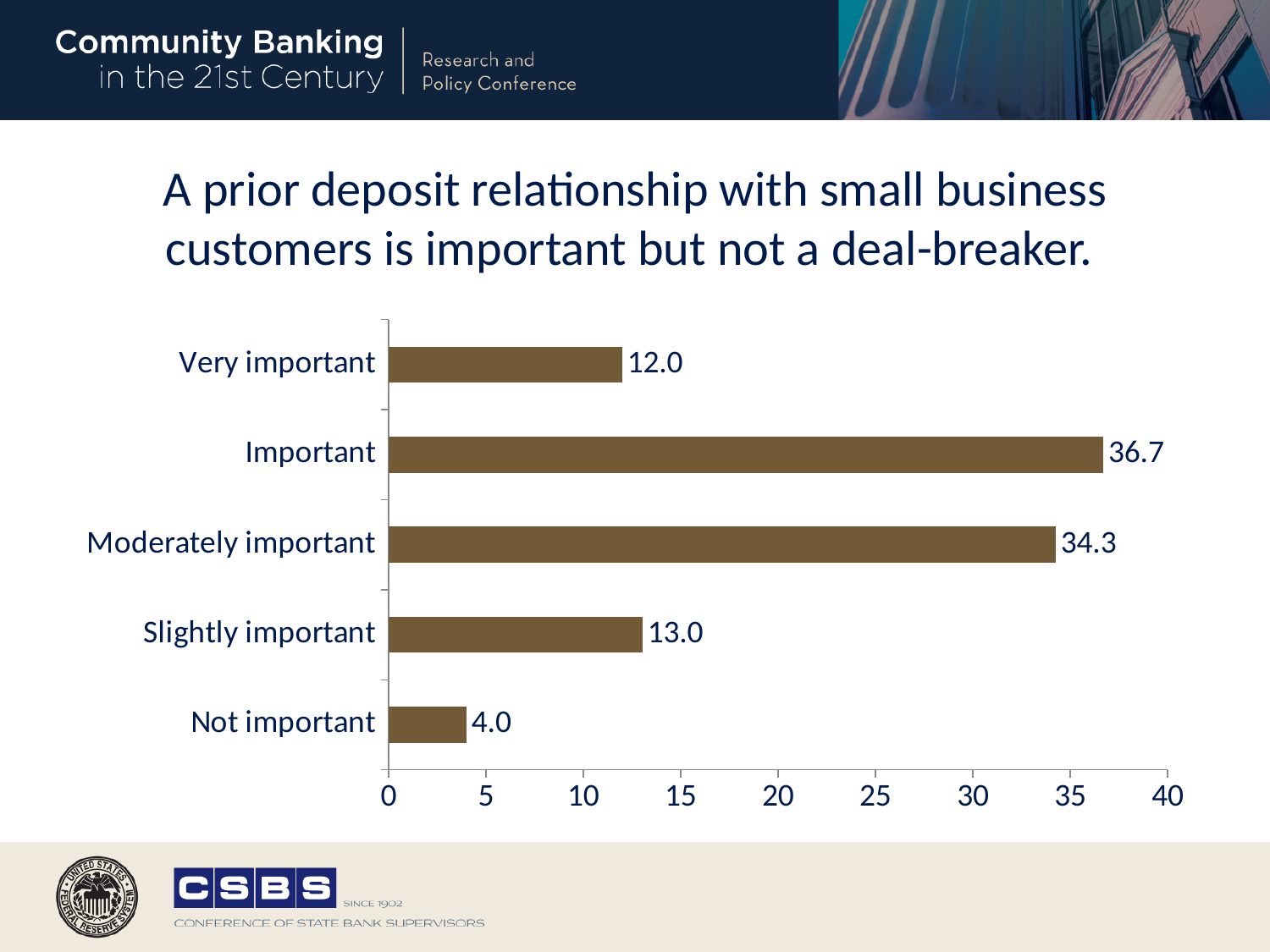
Which category has the lowest value? Not important What is the difference between the values for "Important" and "Moderately important"? 2.4 What kind of chart is shown on the slide? bar chart What is the value for "Important"? 36.7 What is the value for "Very important"? 12.0 Is the value for "Moderately important" greater or less than 30? greater Which category has the highest value? Important What is the maximum value shown on the horizontal axis? 40 How many categories are shown in the chart? 5 Which is larger, the value for "Slightly important" or the value for "Very important"? Slightly important What is the value for "Not important"? 4.0 What is the difference between the values for "Slightly important" and "Not important"? 9.0